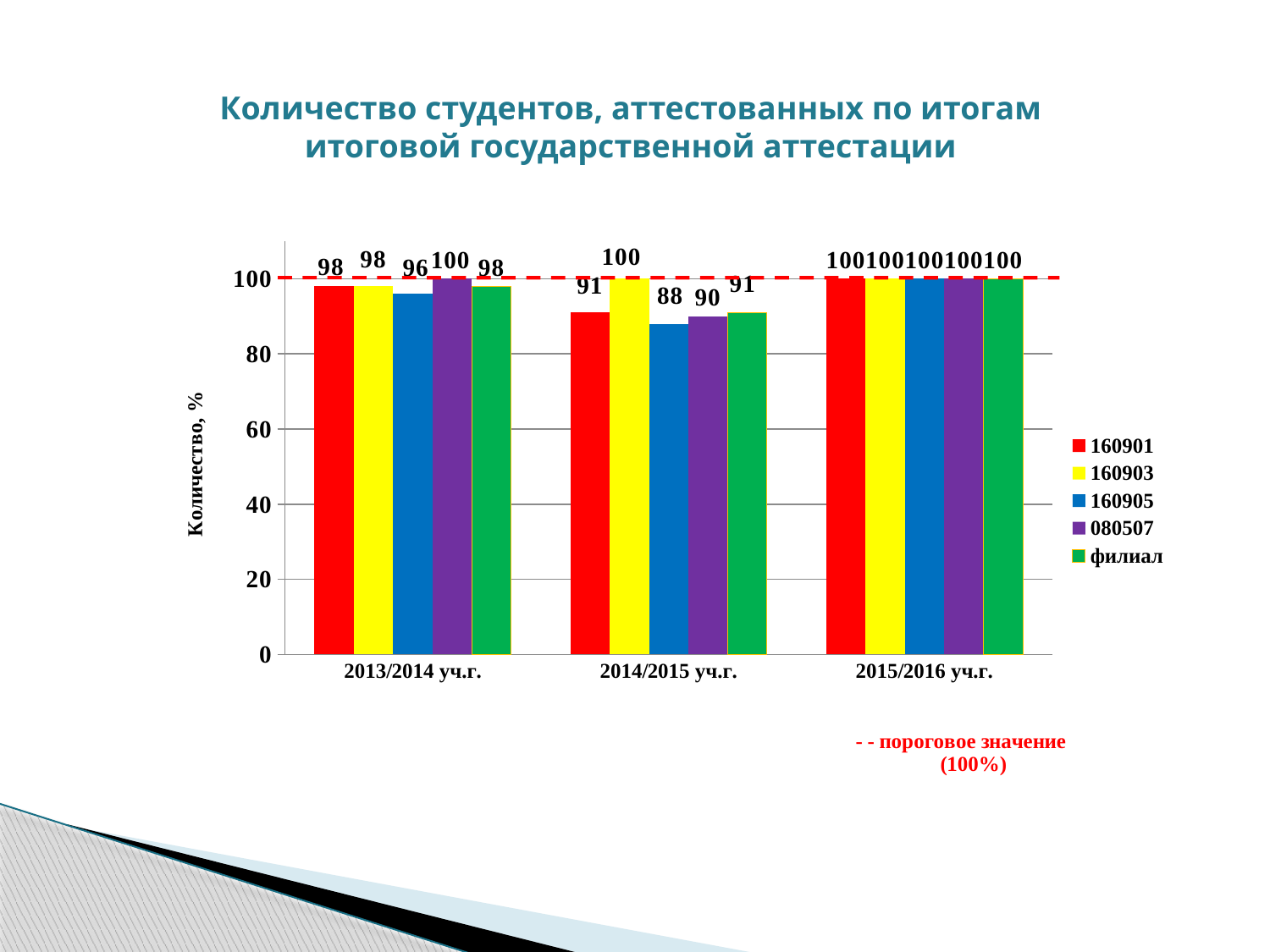
What type of chart is shown on the slide? bar chart Which is larger in 2013/2014 уч.г.: the value for 080507 or the value for 160905? 080507 What is the value for 080507 in 2014/2015 уч.г.? 90 How many academic-year categories are shown on the x axis? 3 What is the difference between the 160903 and 160905 values in 2014/2015 уч.г.? 12 How many series does the legend list? 5 Which series has the lowest value in 2014/2015 уч.г.? 160905 What is the value for 160905 in 2013/2014 уч.г.? 96 What is the value for 160905 in 2014/2015 уч.г.? 88 Which series has the highest value in 2014/2015 уч.г.? 160903 What threshold value does the red dashed line represent? 100% What is the value for филиал in 2015/2016 уч.г.? 100